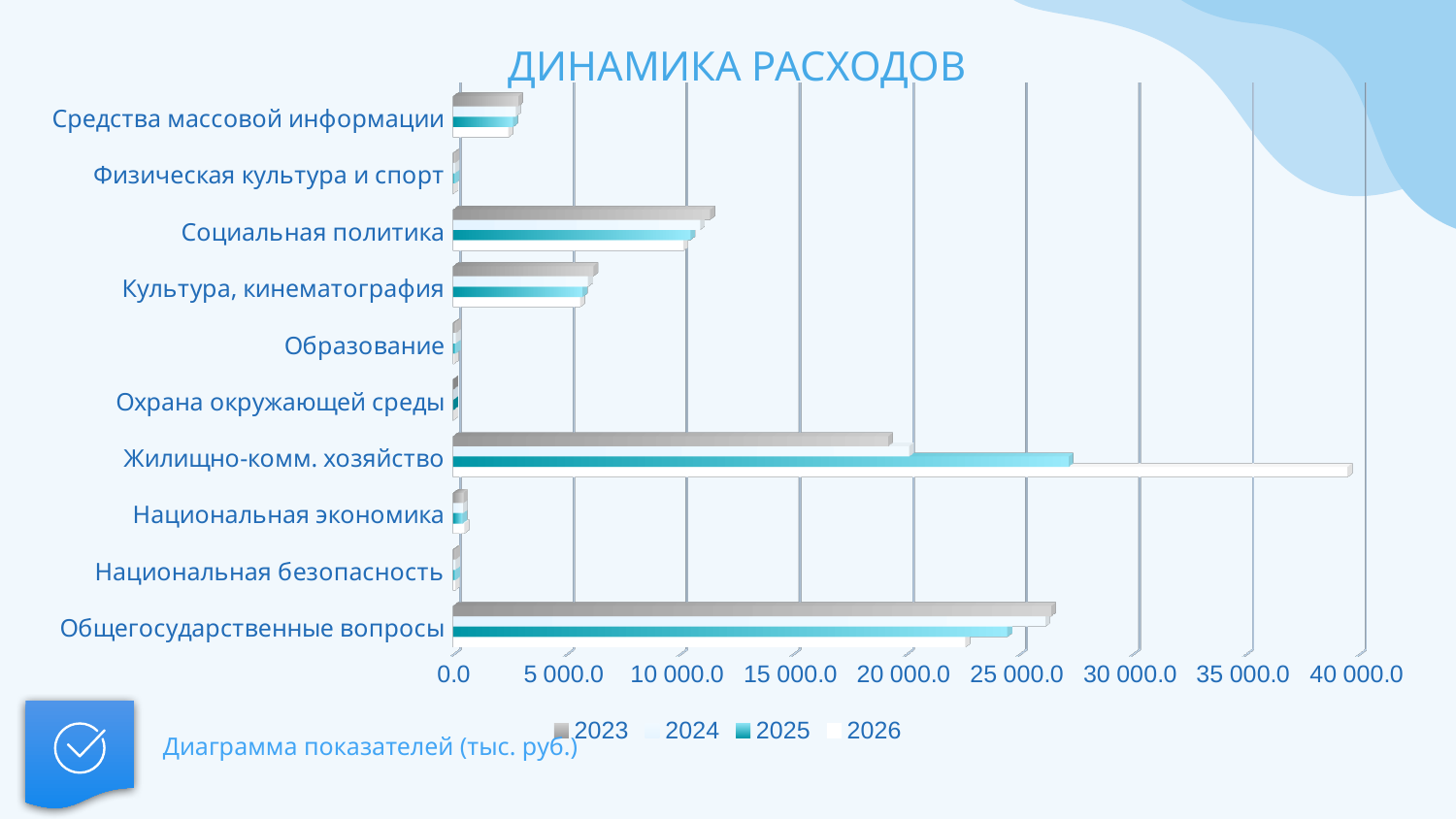
Which years are listed in the chart legend? 2023, 2024, 2025, 2026 Which category has the highest value for 2023? Общегосударственные вопросы For Жилищно-комм. хозяйство, which is larger: the 2023 value or the 2026 value? 2026 Is the 2023 value for Общегосударственные вопросы greater or less than 25 000.0? greater How many series does the chart legend list? 4 Is the 2026 value for Жилищно-комм. хозяйство greater or less than 35 000.0? greater Which category has the longest bar for 2026? Жилищно-комм. хозяйство What is the title of the chart? ДИНАМИКА РАСХОДОВ How many expenditure categories are listed on the vertical axis of the chart? 10 Is the 2023 value for Средства массовой информации greater or less than 5 000.0? less What kind of chart is shown on the slide? bar chart